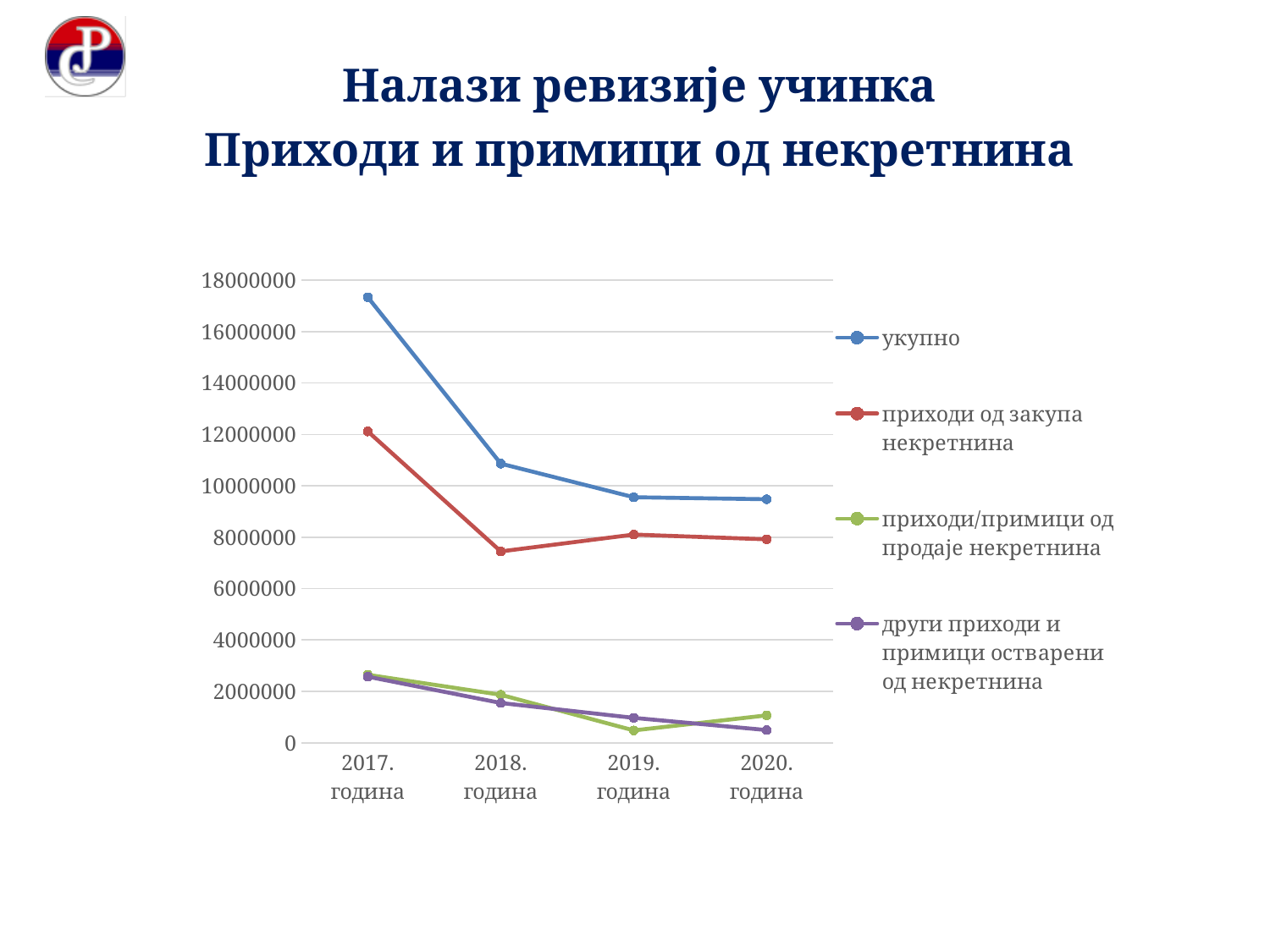
Does the value for укупно rise or fall from 2017. година to 2020. година? fall In which year is the value for приходи од закупа некретнина highest? 2017. година How many series does the legend list? 4 In 2019. година, which is larger: приходи/примици од продаје некретнина or други приходи и примици остварени од некретнина? други приходи и примици остварени од некретнина Is the value for укупно in 2017. година greater or less than 16000000? greater In which year is the value for други приходи и примици остварени од некретнина lowest? 2020. година Is the value for приходи од закупа некретнина in 2018. година greater or less than 8000000? less Is the value for укупно in 2018. година greater or less than 12000000? less In which year is the value for приходи/примици од продаје некретнина lowest? 2019. година What kind of chart is shown on the slide? line chart In which year is the value for укупно highest? 2017. година How many years are shown on the x axis? 4